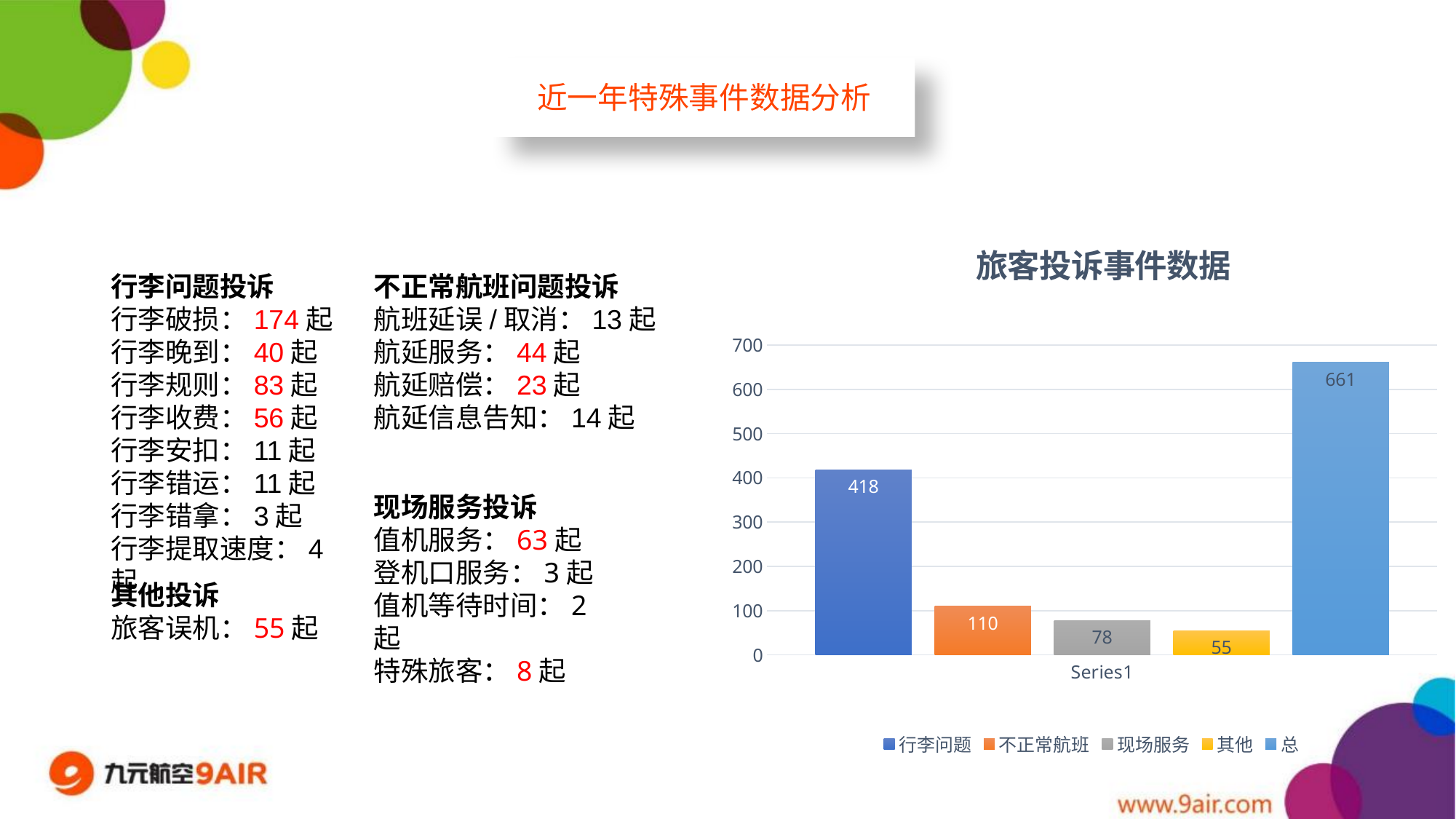
What kind of chart is shown on the slide? Bar chart What is the value for 行李问题 in the chart? 418 How many series does the legend list? 5 What is the difference between the values for 行李问题 and 不正常航班? 308 Which series has the lowest value in the chart? 其他 What is the value for 总 in the chart? 661 What is the value for 其他 in the chart? 55 Which series has the highest value in the chart? 总 What is the value for 现场服务 in the chart? 78 What is the title of the chart? 旅客投诉事件数据 Which is larger, the value for 现场服务 or the value for 其他? 现场服务 What is the value for 不正常航班 in the chart? 110